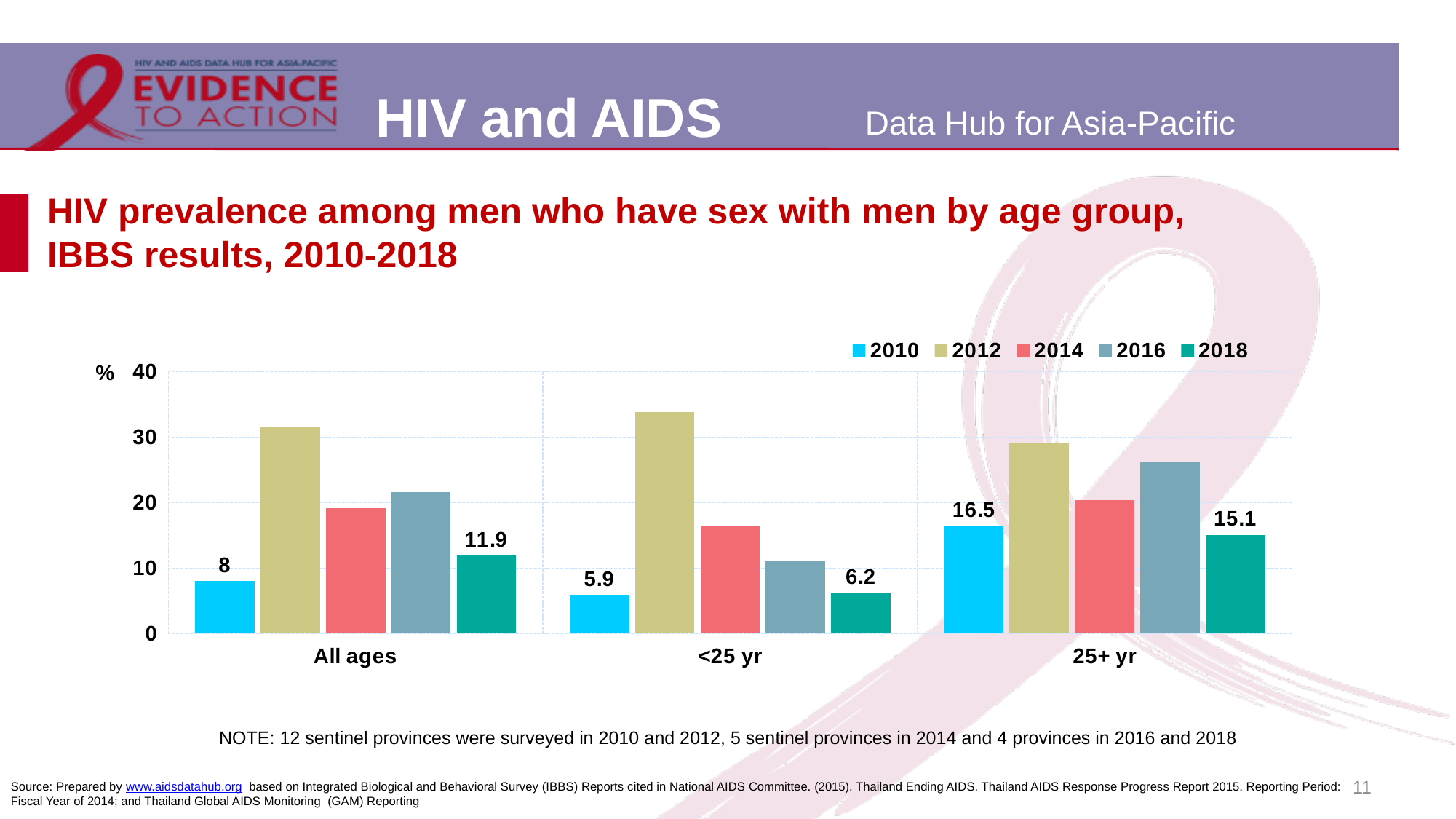
Is the value for 2012 in the <25 yr group greater or less than 30? greater How many age group categories are shown on the x axis? 3 How many series does the legend list? 5 Among the 2010 bars, which age group has the highest value? 25+ yr What is the value for 2010 in the 25+ yr group? 16.5 In the All ages group, which year has the highest bar? 2012 What is the HIV prevalence for 2010 in the All ages group? 8 What is the value for 2018 in the <25 yr group? 6.2 Is the value for 2016 in the <25 yr group greater or less than 20? less In the 25+ yr group, which is larger: the 2010 value or the 2018 value? 2010 In the All ages group, how much higher is the 2018 value than the 2010 value? 3.9 In the 25+ yr group, what is the difference between the 2010 and 2018 values? 1.4